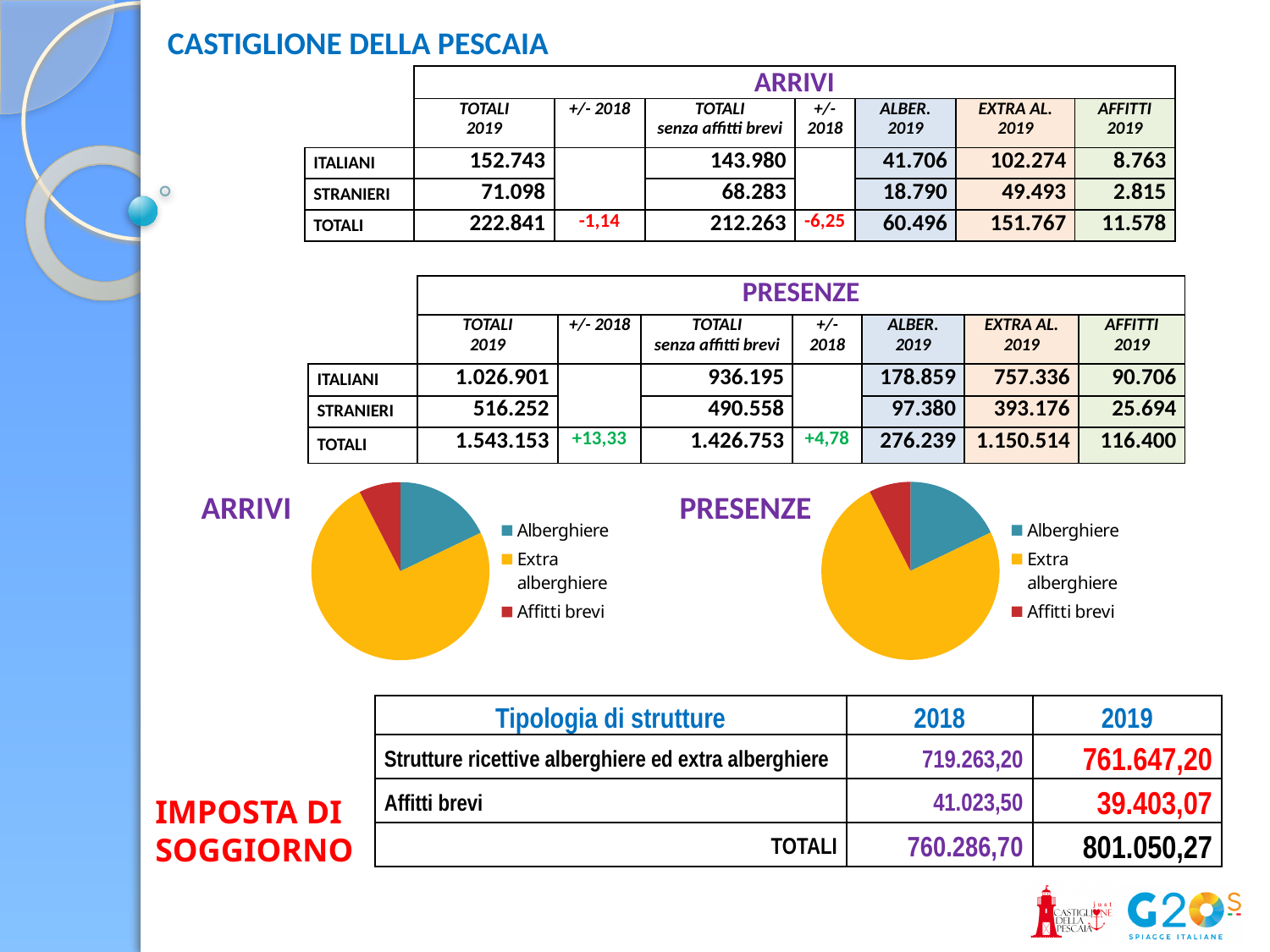
In the PRESENZE pie chart, which category has the smallest slice? Affitti brevi In the ARRIVI pie chart, which slice is larger: Alberghiere or Affitti brevi? Alberghiere In the ARRIVI pie chart, what colour is the Extra alberghiere slice? yellow What kind of chart is the ARRIVI chart? pie chart In the ARRIVI pie chart, which category has the smallest slice? Affitti brevi In the PRESENZE pie chart, which category has the largest slice? Extra alberghiere What kind of chart is the PRESENZE chart? pie chart In the ARRIVI pie chart, which category has the largest slice? Extra alberghiere How many slices does the ARRIVI pie chart have? 3 How many slices does the PRESENZE pie chart have? 3 In the PRESENZE pie chart, which slice is larger: Alberghiere or Affitti brevi? Alberghiere In which pie chart, ARRIVI or PRESENZE, does the Alberghiere slice take a larger share of the pie? ARRIVI